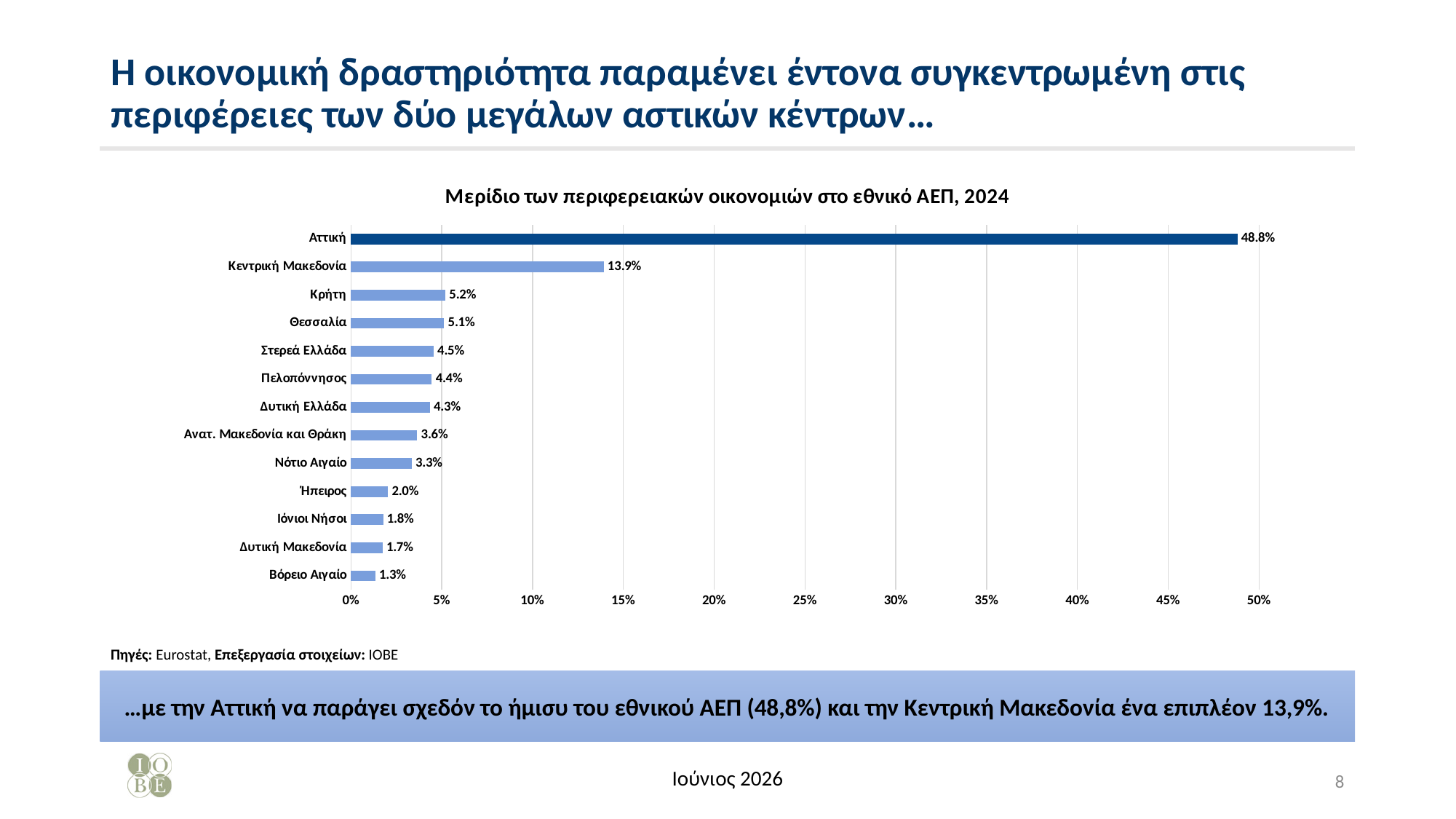
What is the value for Νότιο Αιγαίο? 3.3% What is the difference between the values for Αττική and Κεντρική Μακεδονία? 34.9% Which is larger, the value for Κρήτη or the value for Θεσσαλία? Κρήτη Which region has the highest share? Αττική Which region has the lowest share? Βόρειο Αιγαίο What kind of chart is shown on the slide? Bar chart Is the value for Κεντρική Μακεδονία greater or less than 10%? greater What is the difference between the values for Ήπειρος and Βόρειο Αιγαίο? 0.7% How many regions are shown in the chart? 13 What is the value for Κεντρική Μακεδονία? 13.9% What is the title of the chart? Μερίδιο των περιφερειακών οικονομιών στο εθνικό ΑΕΠ, 2024 What is the value for Αττική? 48.8%